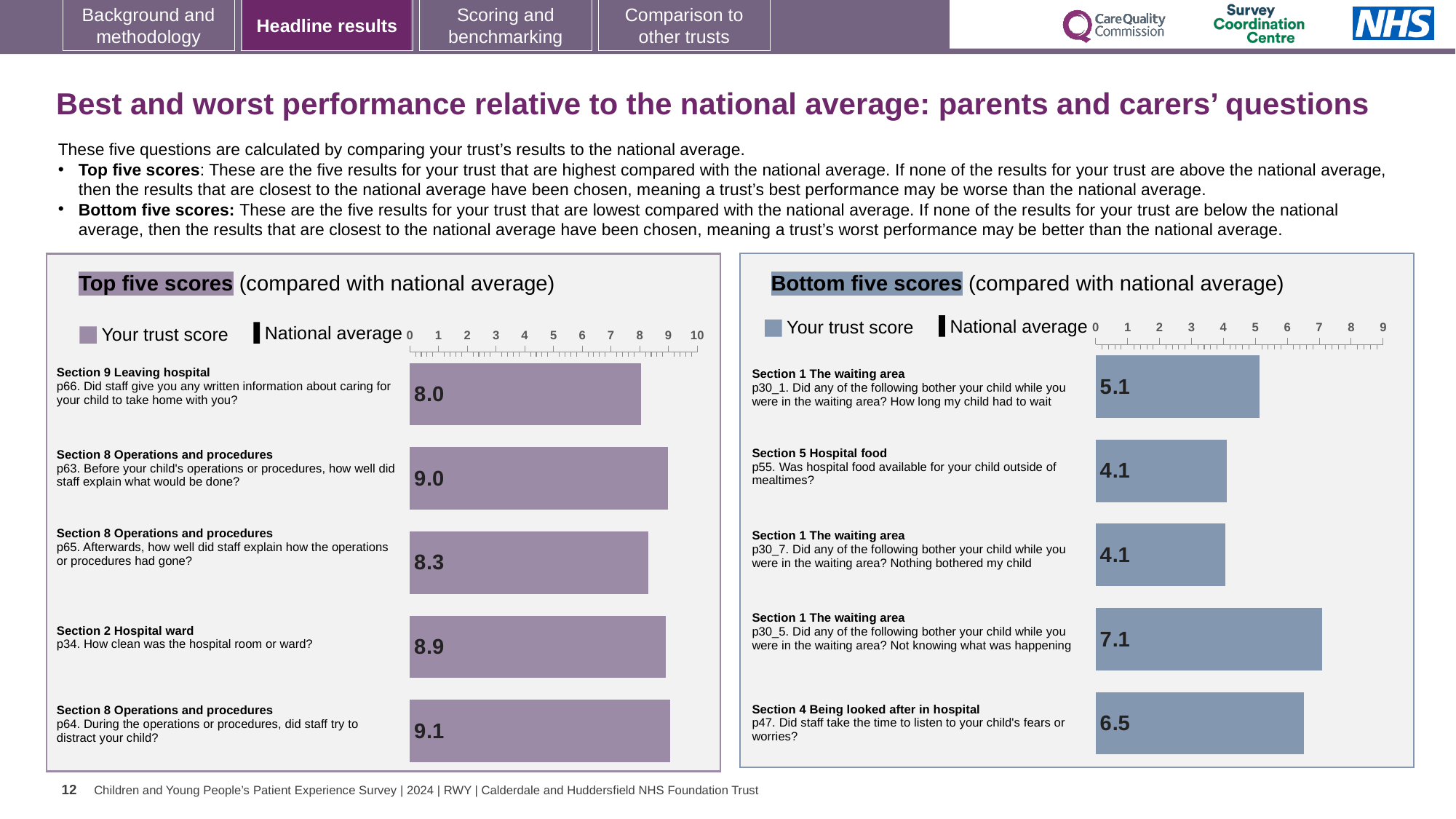
In the Bottom five scores chart, what is the trust score for p47 (Did staff take the time to listen to your child's fears or worries?)? 6.5 What kind of chart is the Top five scores chart? Bar chart In the Top five scores chart, what is the trust score for p34 (How clean was the hospital room or ward?)? 8.9 In the Bottom five scores chart, what is the trust score for p30_5 (Not knowing what was happening)? 7.1 In the Bottom five scores chart, which has the larger trust score: p30_1 (How long my child had to wait) or p47 (listen to your child's fears or worries)? p47 In the Top five scores chart, what is the difference between the trust scores for p63 and p65? 0.7 In the Bottom five scores chart, what is the difference between the trust scores for p30_1 and p55? 1.0 How many entries does the legend of the Top five scores chart list? 2 In the Top five scores chart, which question has the lowest trust score? p66. Did staff give you any written information about caring for your child to take home with you? In the Top five scores chart, what is the trust score for p64 (During the operations or procedures, did staff try to distract your child?)? 9.1 In the Bottom five scores chart, which question has the highest trust score? p30_5. Did any of the following bother your child while you were in the waiting area? Not knowing what was happening How many questions are shown in the Bottom five scores chart? 5